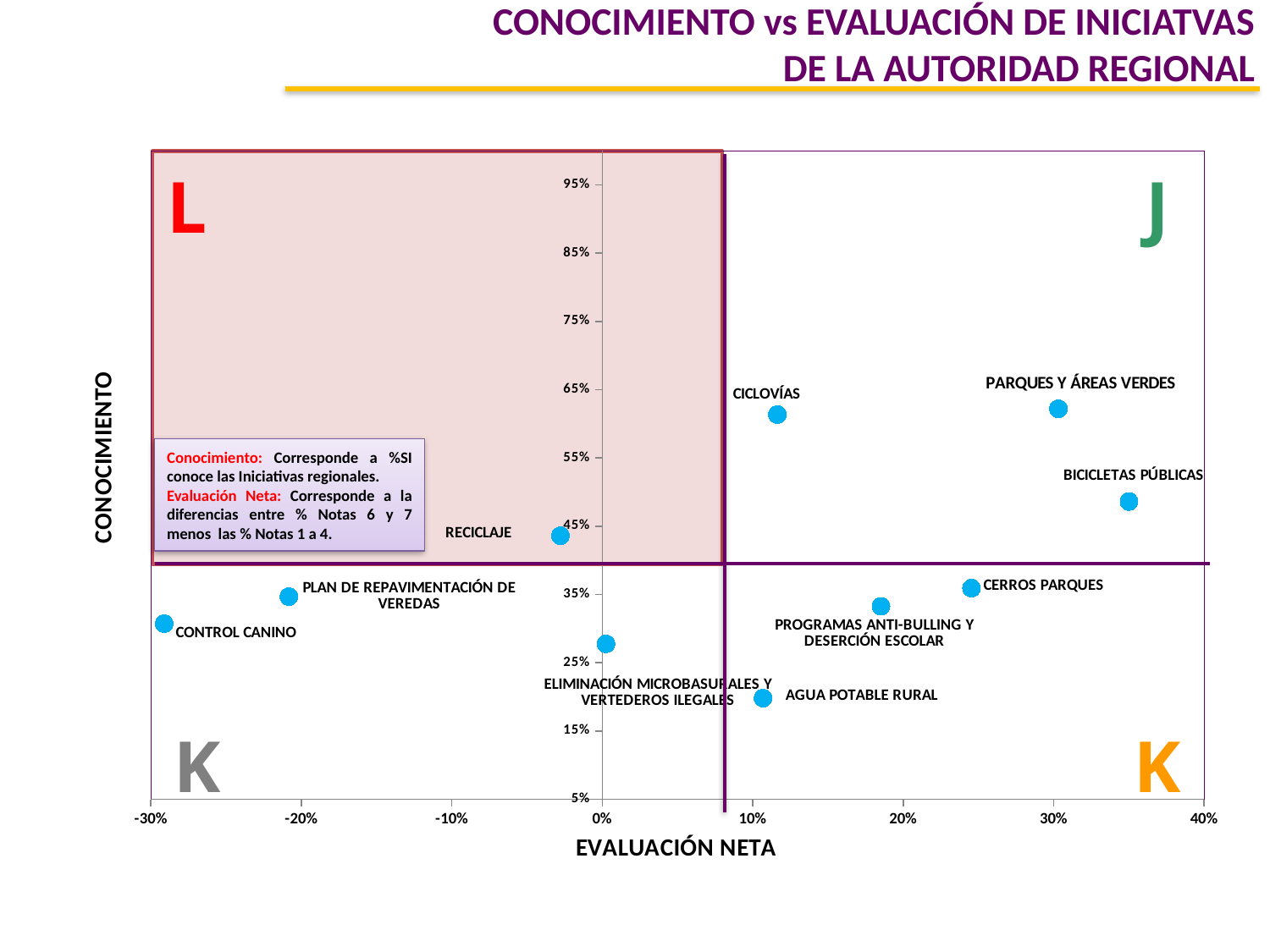
Is the EVALUACIÓN NETA value for CONTROL CANINO greater or less than -20%? less Which initiative has the highest EVALUACIÓN NETA value? BICICLETAS PÚBLICAS Is the EVALUACIÓN NETA value for BICICLETAS PÚBLICAS greater or less than 30%? greater How many initiatives are plotted as points on the chart? 10 Is the CONOCIMIENTO value for AGUA POTABLE RURAL greater or less than 25%? less What kind of chart is shown on the slide? Scatter chart Which initiative has the lowest EVALUACIÓN NETA value? CONTROL CANINO What is the title of the horizontal axis of the chart? EVALUACIÓN NETA Which initiative has the lowest CONOCIMIENTO value? AGUA POTABLE RURAL Which has a higher EVALUACIÓN NETA value, CICLOVÍAS or PARQUES Y ÁREAS VERDES? PARQUES Y ÁREAS VERDES Which has a higher CONOCIMIENTO value, PARQUES Y ÁREAS VERDES or BICICLETAS PÚBLICAS? PARQUES Y ÁREAS VERDES